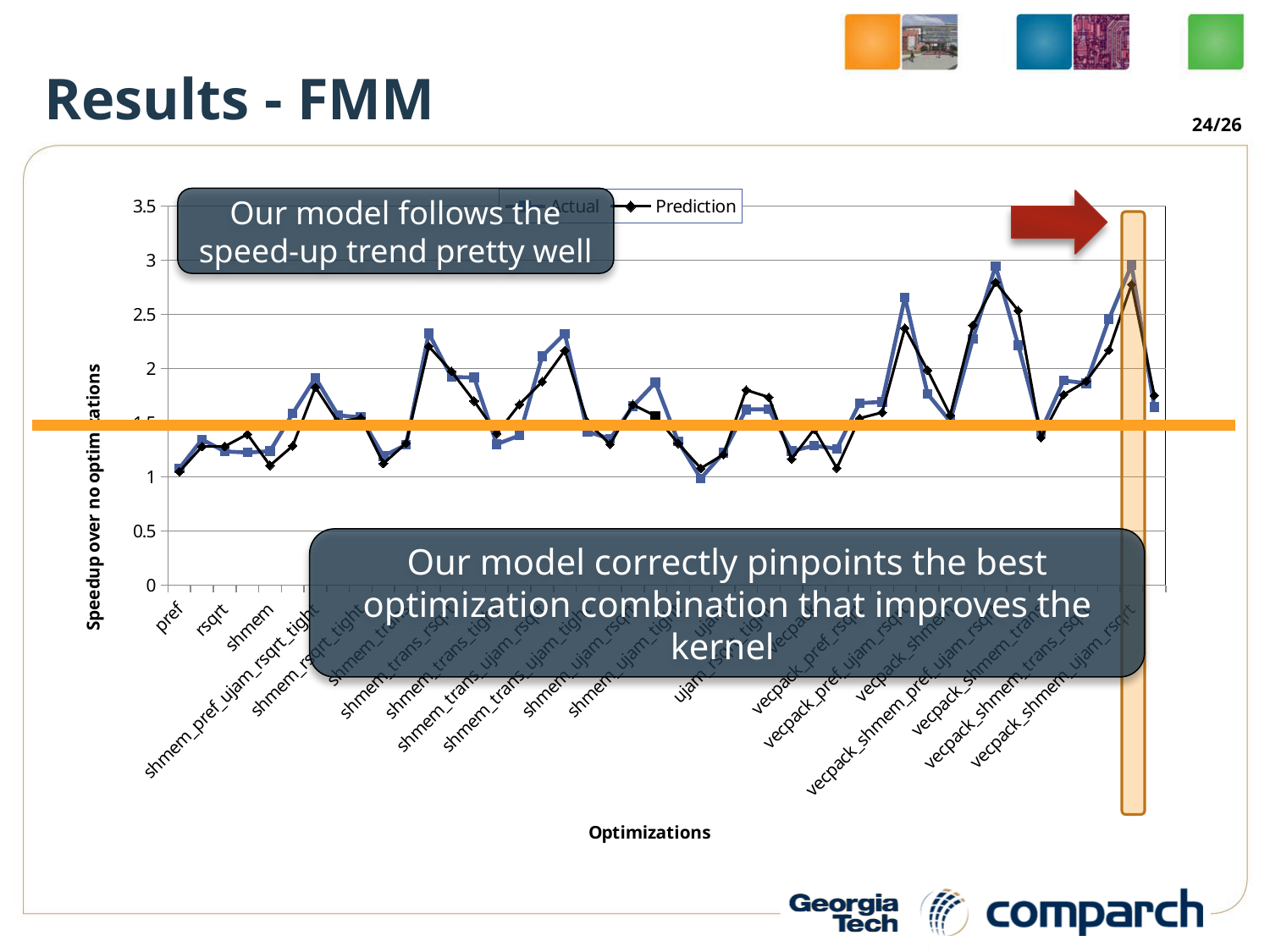
Is the Actual value for rsqrt greater or less than 1? greater How many series does the chart's legend list? 2 What is the title of the chart's vertical axis? Speedup over no optimizations Is the Prediction value for shmem greater or less than 2.5? less Is the Prediction value for rsqrt greater or less than 1.5? less What kind of chart is shown on the slide? line chart What are the two series named in the chart's legend? Actual and Prediction